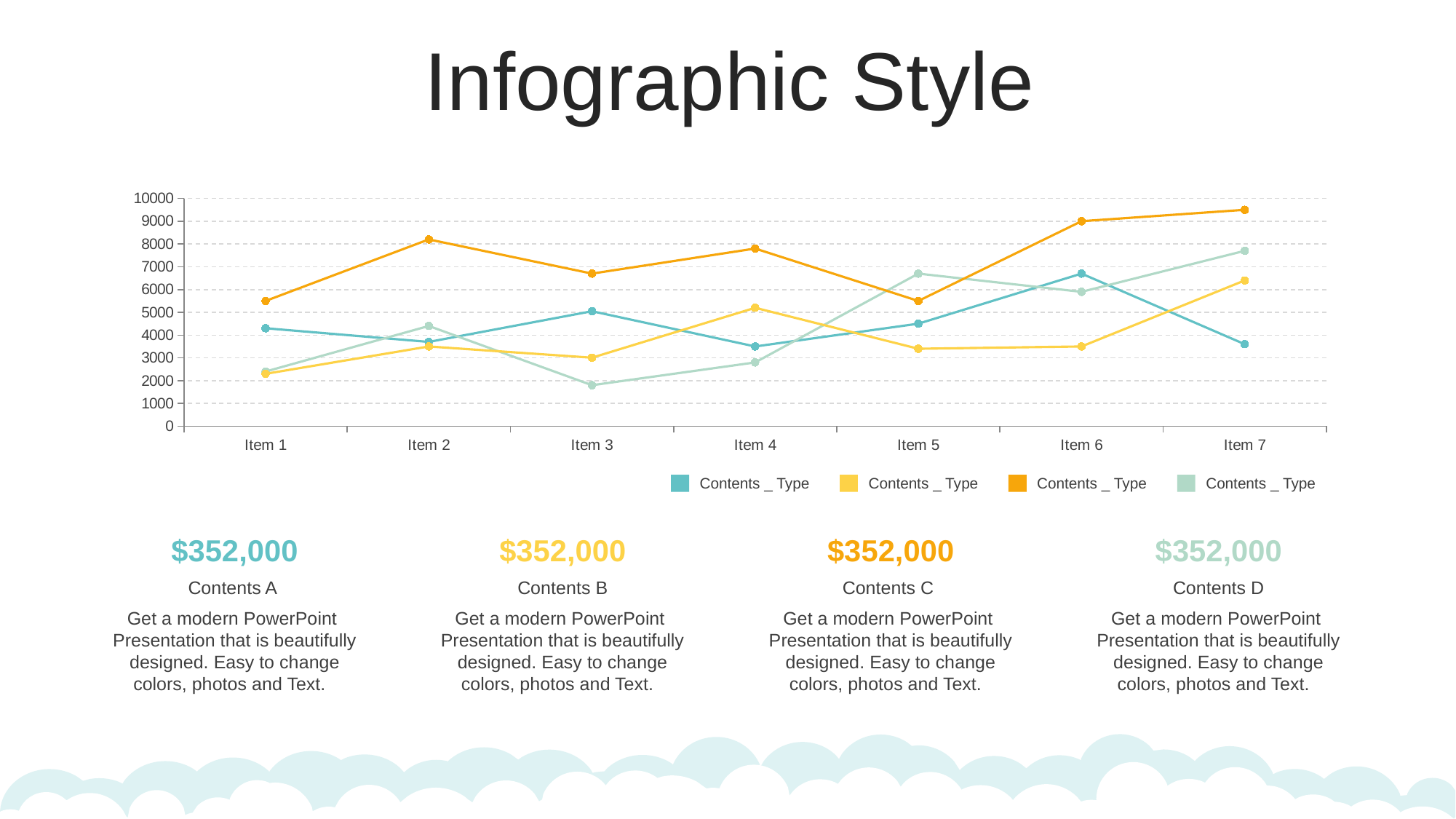
How many items (categories) are plotted along the x axis? 7 Is the value of the light green line at Item 3 greater or less than 3000? less At Item 4, which is higher: the orange line or the yellow line? orange line Does the orange line rise or fall from Item 5 to Item 7? rise At which item does the teal line reach its highest value? Item 6 Is the value of the yellow line at Item 7 greater or less than 6000? greater How many series does the legend list? 4 At which item does the orange line reach its highest value? Item 7 At which item does the light green line reach its lowest value? Item 3 Is the value of the teal line at Item 6 greater or less than 6000? greater What kind of chart is shown on the slide? line chart